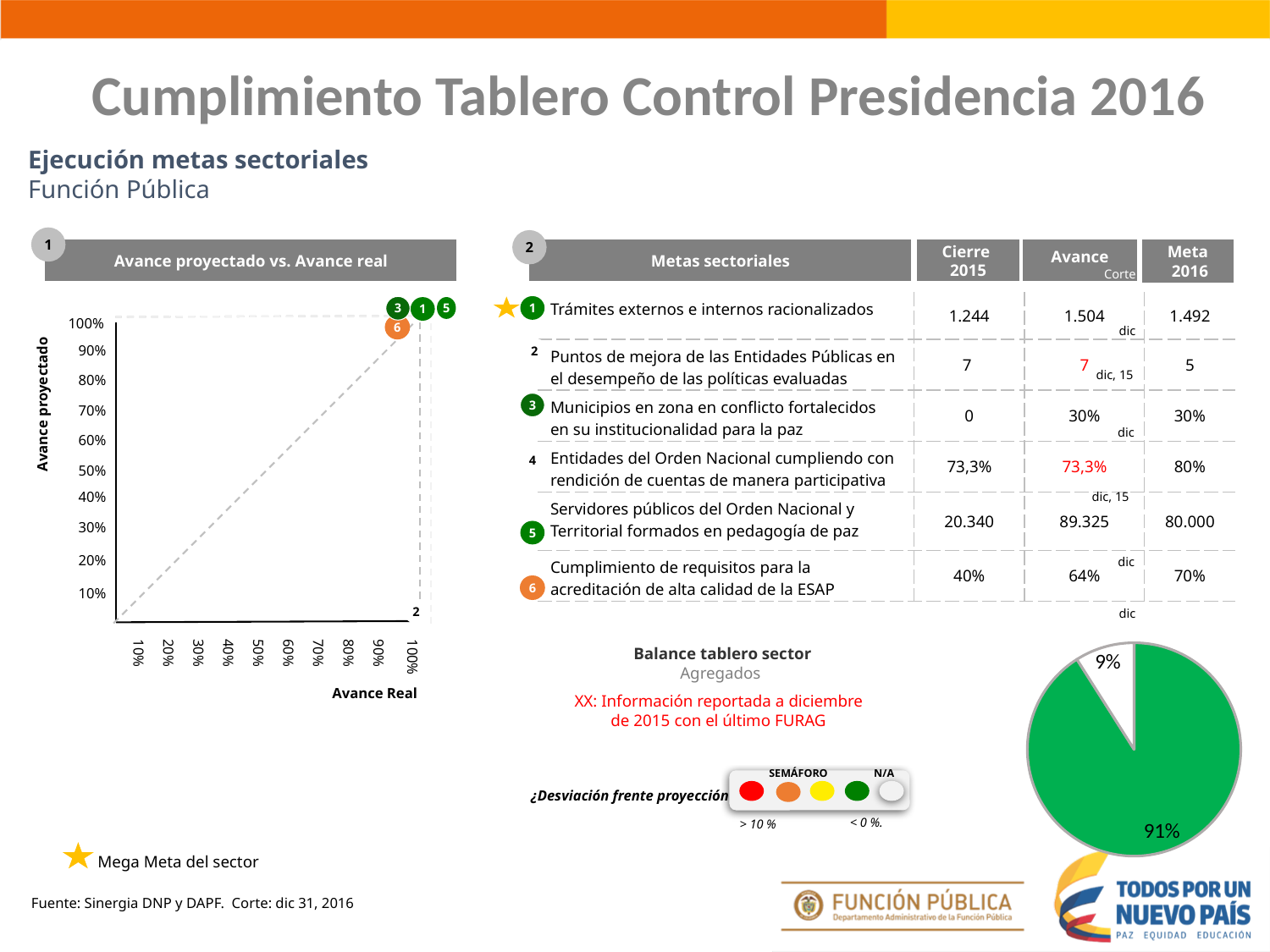
What is the subtitle shown under the title 'Balance tablero sector' of the pie chart? Agregados What kind of chart is the 'Avance proyectado vs. Avance real' chart on the left of the slide? Scatter chart What kind of chart is the 'Balance tablero sector' chart at the bottom right of the slide? Pie chart In the pie chart titled 'Balance tablero sector', what is the value of the largest slice? 91% In the 'Avance proyectado vs. Avance real' chart, what is the title of the horizontal axis? Avance Real In the 'Avance proyectado vs. Avance real' chart, what is the highest tick label shown on the vertical axis? 100% How many slices does the pie chart titled 'Balance tablero sector' have? 2 In the 'Avance proyectado vs. Avance real' chart, is the 'Avance proyectado' value for point 6 greater or less than 50%? greater In the pie chart titled 'Balance tablero sector', what is the value of the smallest slice? 9% In the pie chart titled 'Balance tablero sector', which slice is larger, the green one or the white one? The green one In the pie chart titled 'Balance tablero sector', what is the difference in percentage points between the two slices? 82 percentage points In the 'Avance proyectado vs. Avance real' chart, is the 'Avance proyectado' value for point 2 greater or less than 50%? less